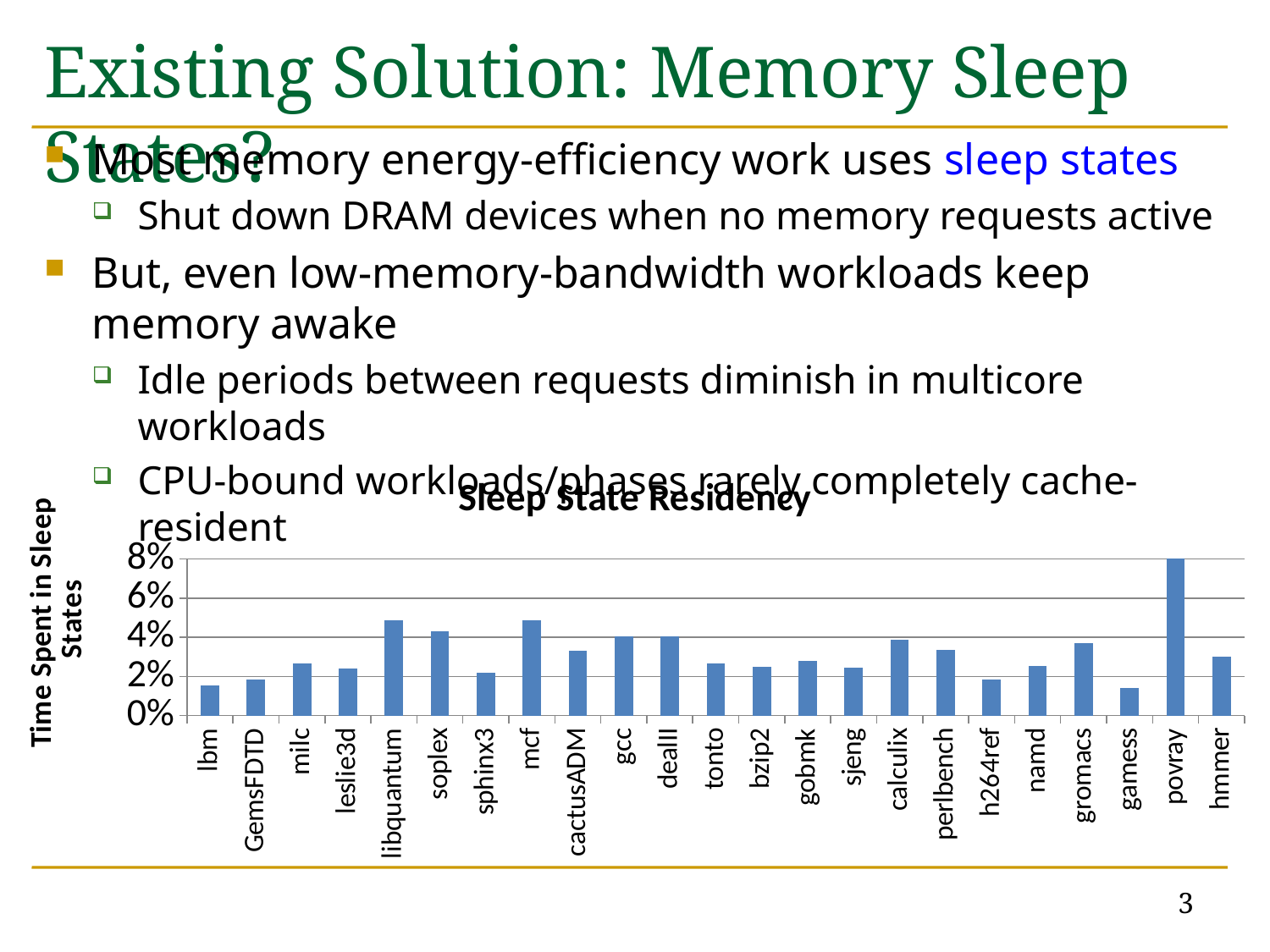
Is the value for sphinx3 greater or less than 4%? less Which has a higher value, gamess or gromacs? gromacs Is the value for lbm greater or less than 2%? less What is the title of the chart? Sleep State Residency What kind of chart is shown on the slide? bar chart Which workload has the highest time spent in sleep states? povray Which has a higher value, mcf or tonto? mcf How many workloads (categories) are plotted in the chart? 23 Is the value for povray greater or less than 6%? greater Which has a higher value, libquantum or sphinx3? libquantum What is the label on the vertical axis of the chart? Time Spent in Sleep States